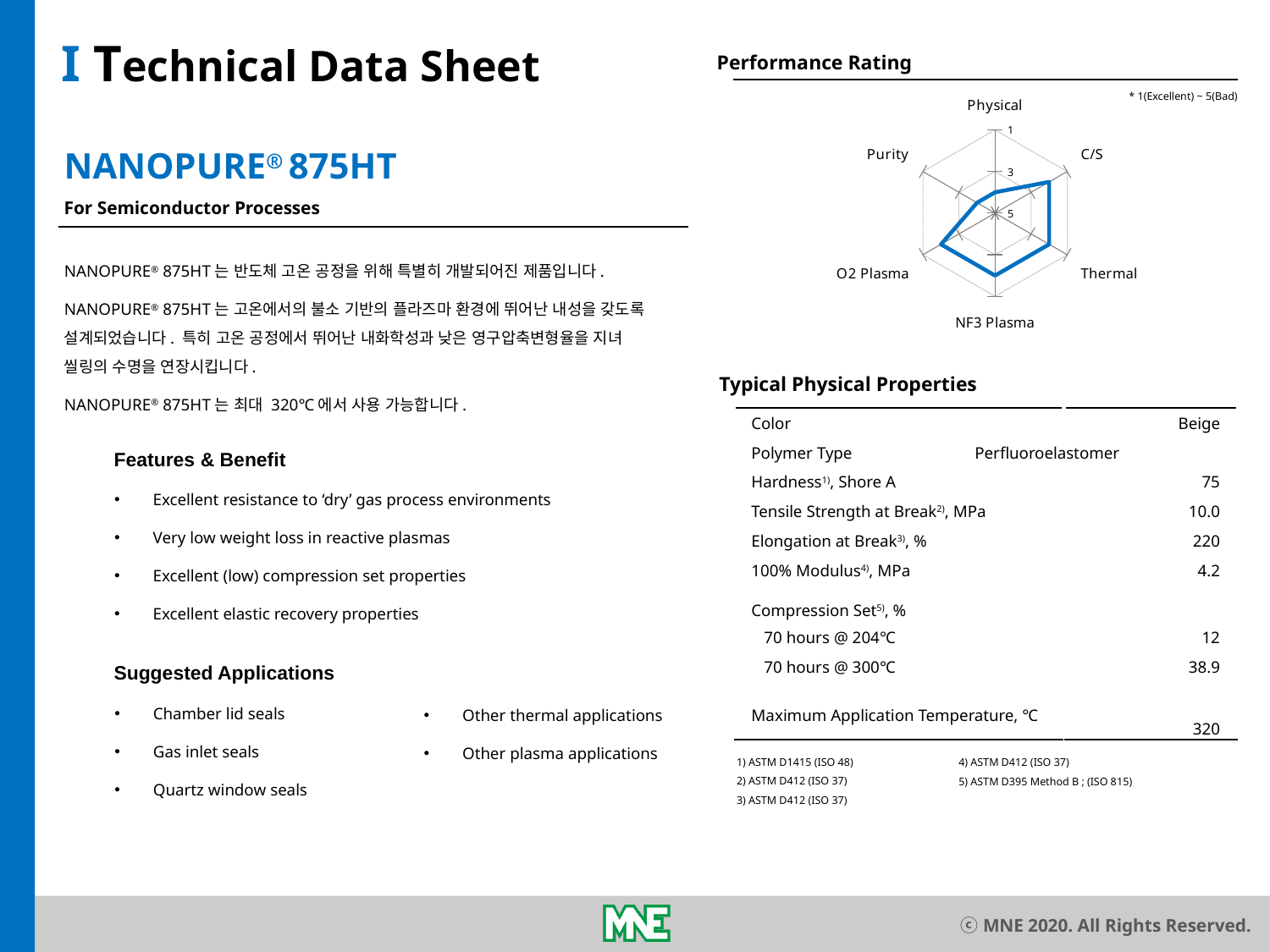
On the Performance Rating chart, is the value for O2 Plasma greater or less than 3? less How many categories (axes) does the Performance Rating radar chart have? 6 On the Performance Rating chart, which category has the highest rating value (closest to the centre)? Physical and Purity (tied) On the Performance Rating chart, is the value for Thermal greater or less than 3? less On the Performance Rating chart, is the value for NF3 Plasma greater or less than 3? less What is the title of the chart on the slide? Performance Rating According to the note on the Performance Rating chart, what rating value means Excellent? 1 How many data series are plotted on the Performance Rating chart? 1 What kind of chart is the Performance Rating chart? radar chart On the Performance Rating chart, which has the larger rating value, Purity or Thermal? Purity